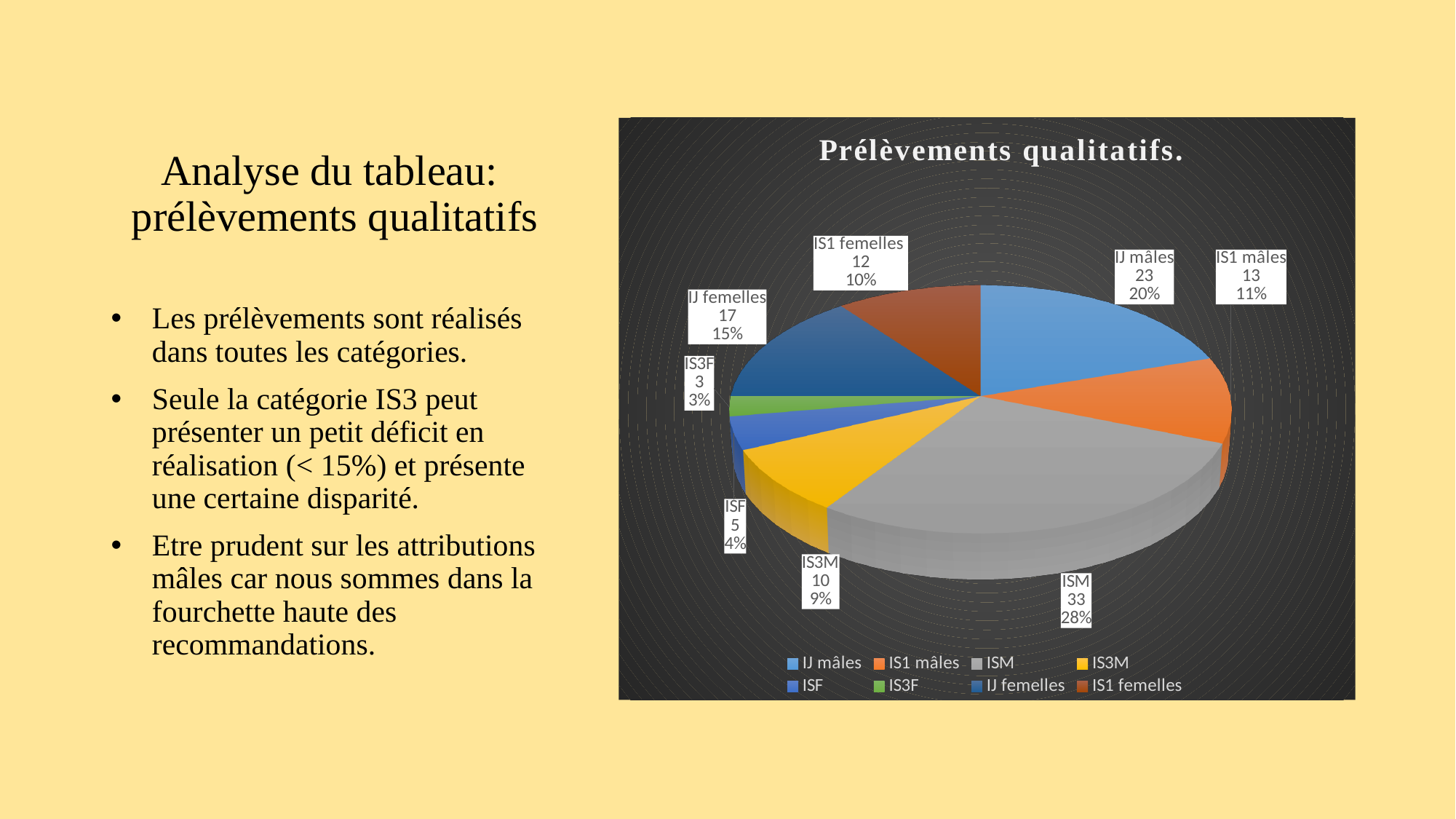
What percentage share does IS3M have? 9% How many categories does the pie chart have? 8 What is the title of the chart? Prélèvements qualitatifs. Which is larger, the value for ISF or the value for IS3M? IS3M What is the value for ISM? 33 What colour is the ISM slice? grey What is the value for IJ femelles? 17 Which category has the smallest slice? IS3F What percentage share does IS1 mâles have? 11% Which category has the largest slice? ISM What kind of chart is shown on the slide? pie chart What is the difference between the values for IJ mâles and IS1 femelles? 11